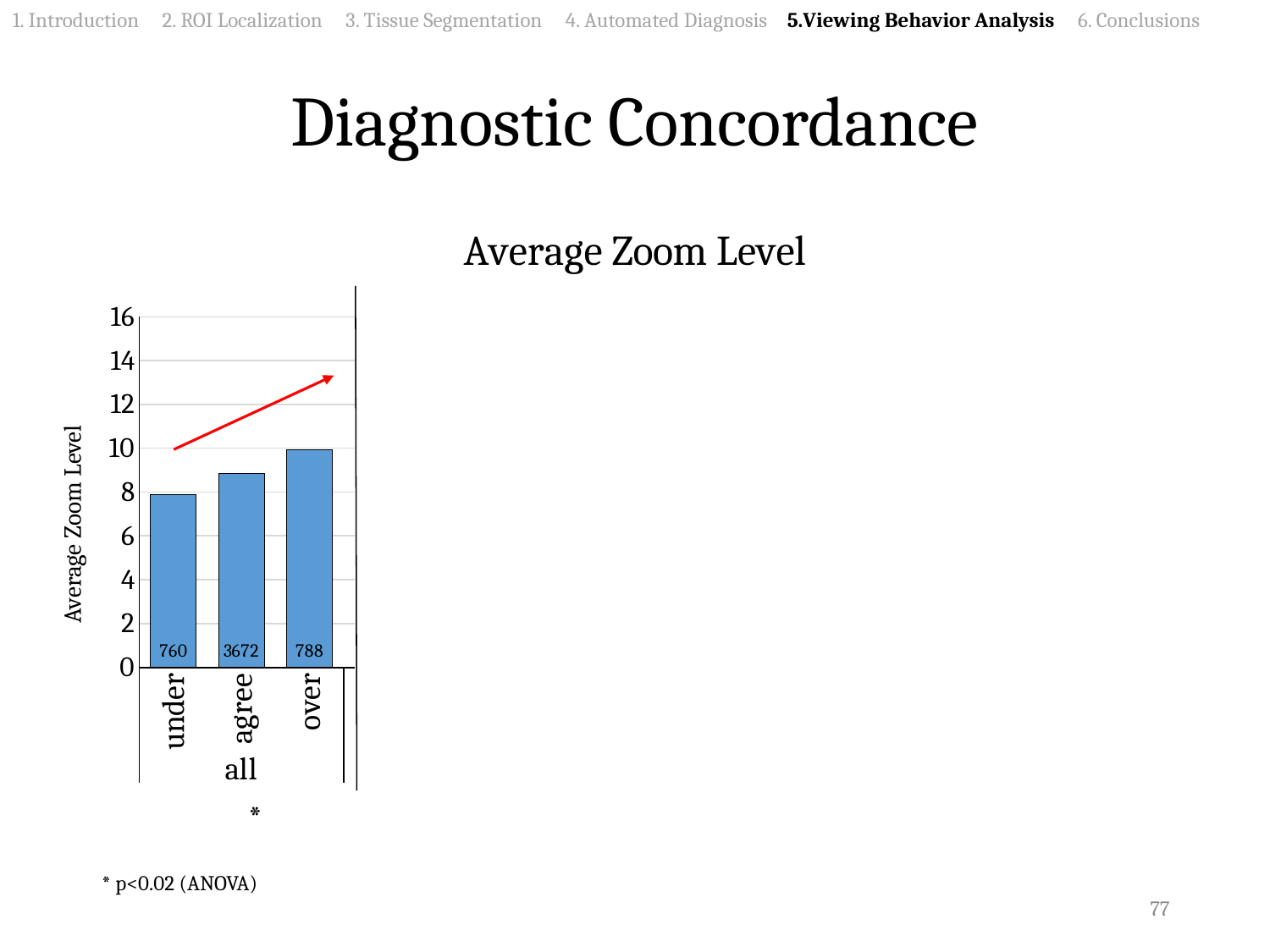
Is the average zoom level for agree greater or less than 10? less Is the average zoom level for over greater or less than 12? less Do the bars rise or fall from under to over along the x axis? rise Is the average zoom level for agree greater or less than 8? greater What type of chart is shown on the slide? bar chart Which category has the highest average zoom level? over Which category has the lowest average zoom level? under What number is printed inside the bar for agree? 3672 How many bars are plotted in the Average Zoom Level chart? 3 What is the title of the chart? Average Zoom Level Which is larger, the average zoom level for over or for under? over